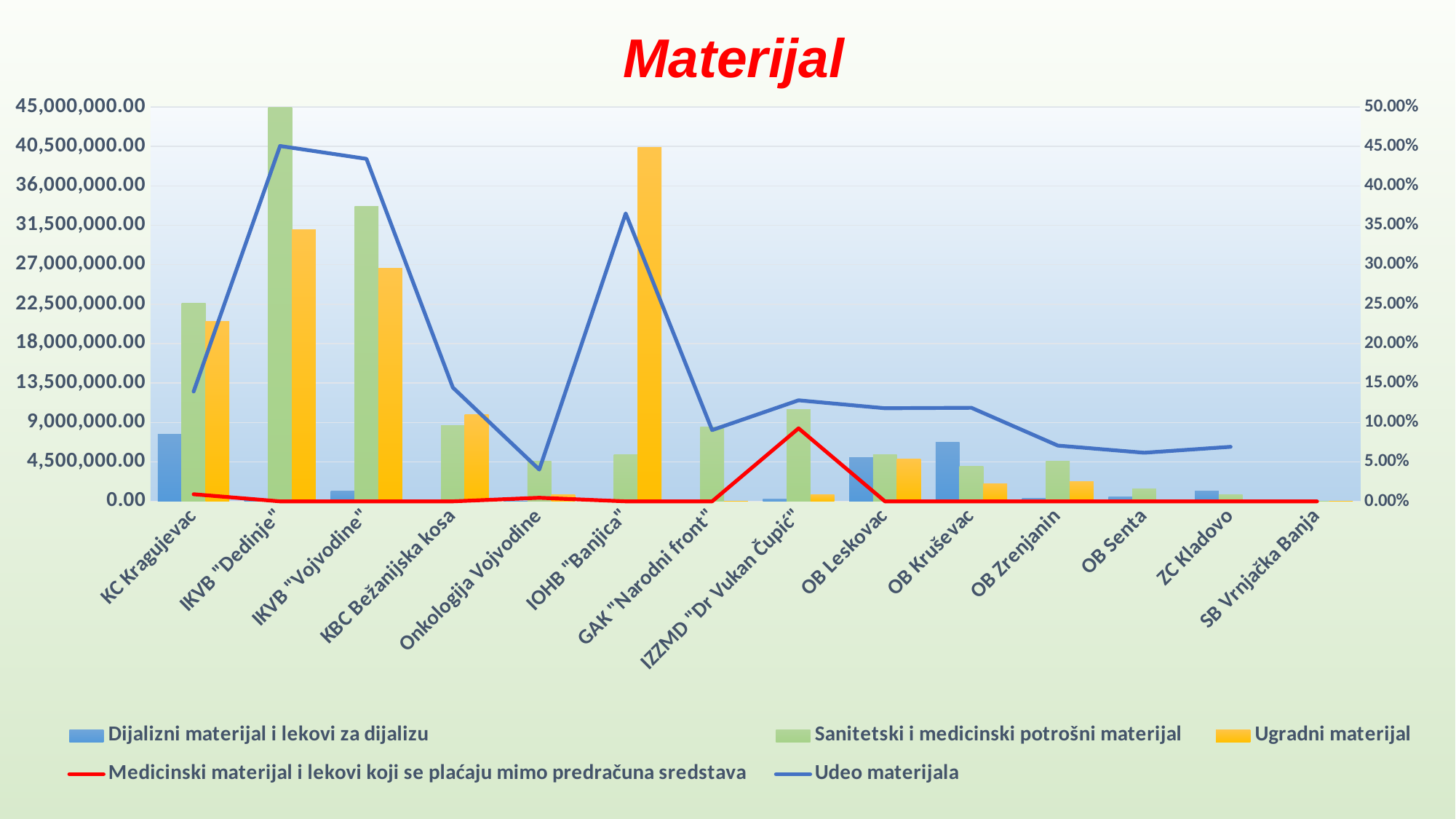
Which institution has the highest value for Ugradni materijal? IOHB "Banjica" How many institutions (categories) are shown on the x axis? 14 Is the Udeo materijala for Onkologija Vojvodine greater or less than 10.00%? less What is the title of the chart? Materijal At which institution does the Medicinski materijal i lekovi koji se plaćaju mimo predračuna sredstava line reach its peak? IZZMD "Dr Vukan Čupić" Which institution has the highest value for Sanitetski i medicinski potrošni materijal? IKVB "Dedinje" How many series does the legend list? 5 Is the Ugradni materijal value for IOHB "Banjica" greater or less than 36,000,000.00? greater Is the Sanitetski i medicinski potrošni materijal value for IKVB "Dedinje" greater or less than 36,000,000.00? greater Which has the larger Ugradni materijal value, IKVB "Dedinje" or IKVB "Vojvodine"? IKVB "Dedinje" What kind of chart is shown on the slide? Combined bar and line chart